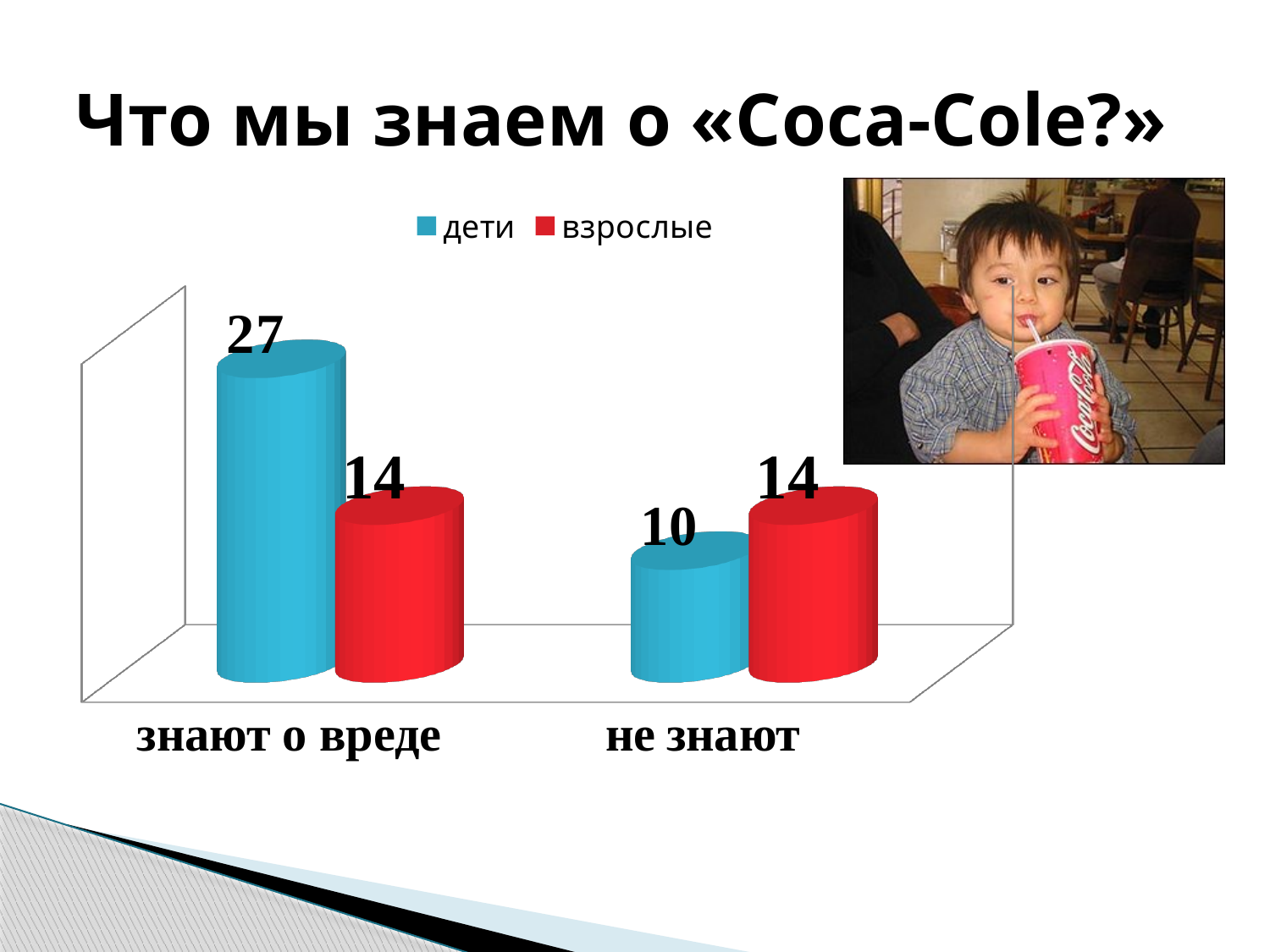
What is the value for взрослые in the category знают о вреде? 14 What is the difference between дети in знают о вреде and дети in не знают? 17 Which category has the lowest value for дети? не знают What is the difference between дети and взрослые in the category знают о вреде? 13 How many categories are shown on the x axis? 2 What kind of chart is shown on the slide? bar chart What is the value for дети in the category знают о вреде? 27 How many series does the legend list? 2 What is the value for взрослые in the category не знают? 14 What is the value for дети in the category не знают? 10 In the category не знают, which is larger: дети or взрослые? взрослые Which category has the highest value for дети? знают о вреде